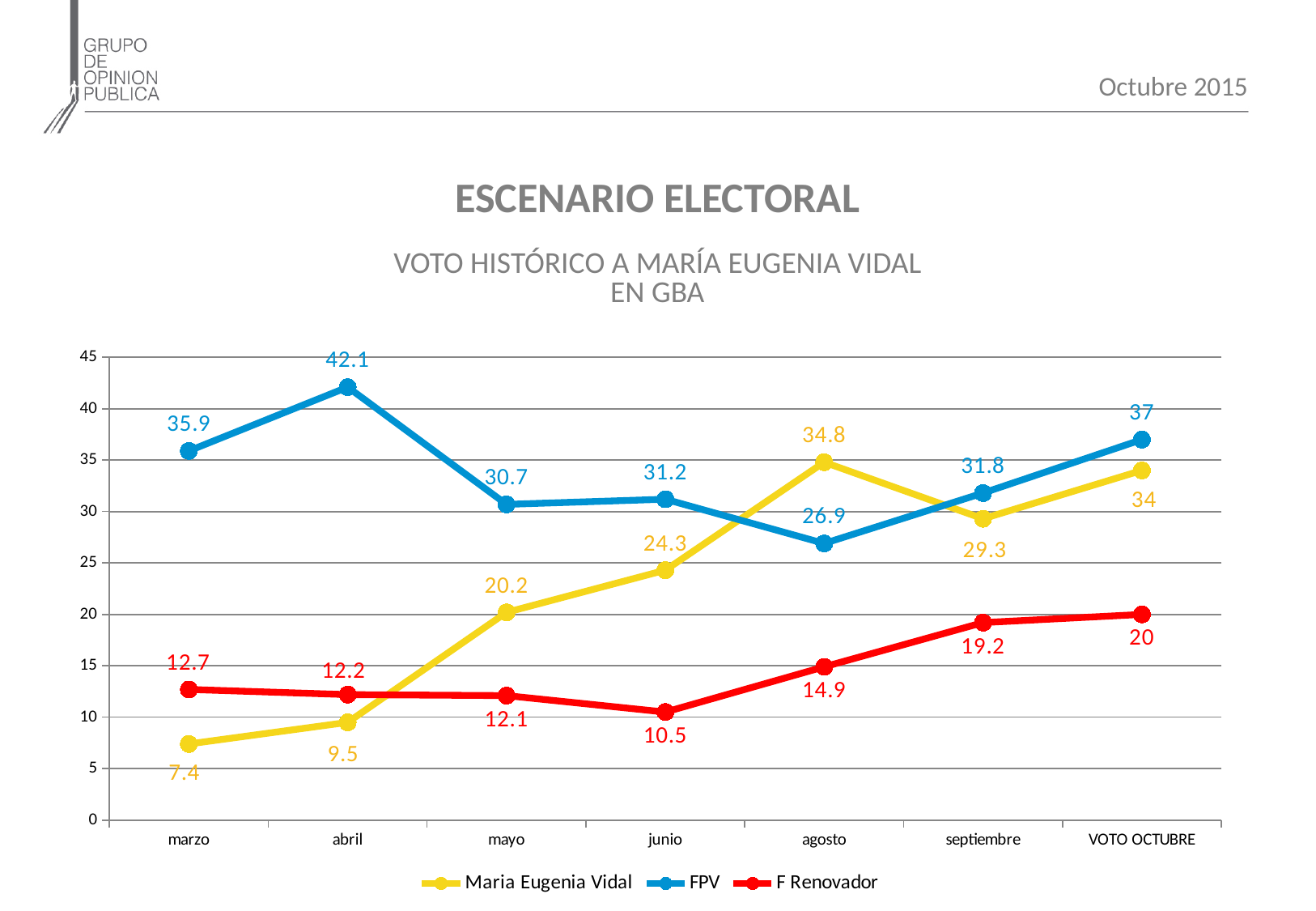
What is the value for Maria Eugenia Vidal in agosto? 34.8 Which is larger in agosto: Maria Eugenia Vidal or FPV? Maria Eugenia Vidal How many time points are shown on the x axis? 7 Does the Maria Eugenia Vidal series rise or fall from marzo to junio? rise In which month is the Maria Eugenia Vidal series at its lowest value? marzo What is the difference between FPV and Maria Eugenia Vidal in VOTO OCTUBRE? 3 What colour is the line for F Renovador? red In which month does the FPV series reach its highest value? abril What is the value for FPV in abril? 42.1 What kind of chart is shown on the slide? line chart How many series does the legend list? 3 What is the value for F Renovador in junio? 10.5